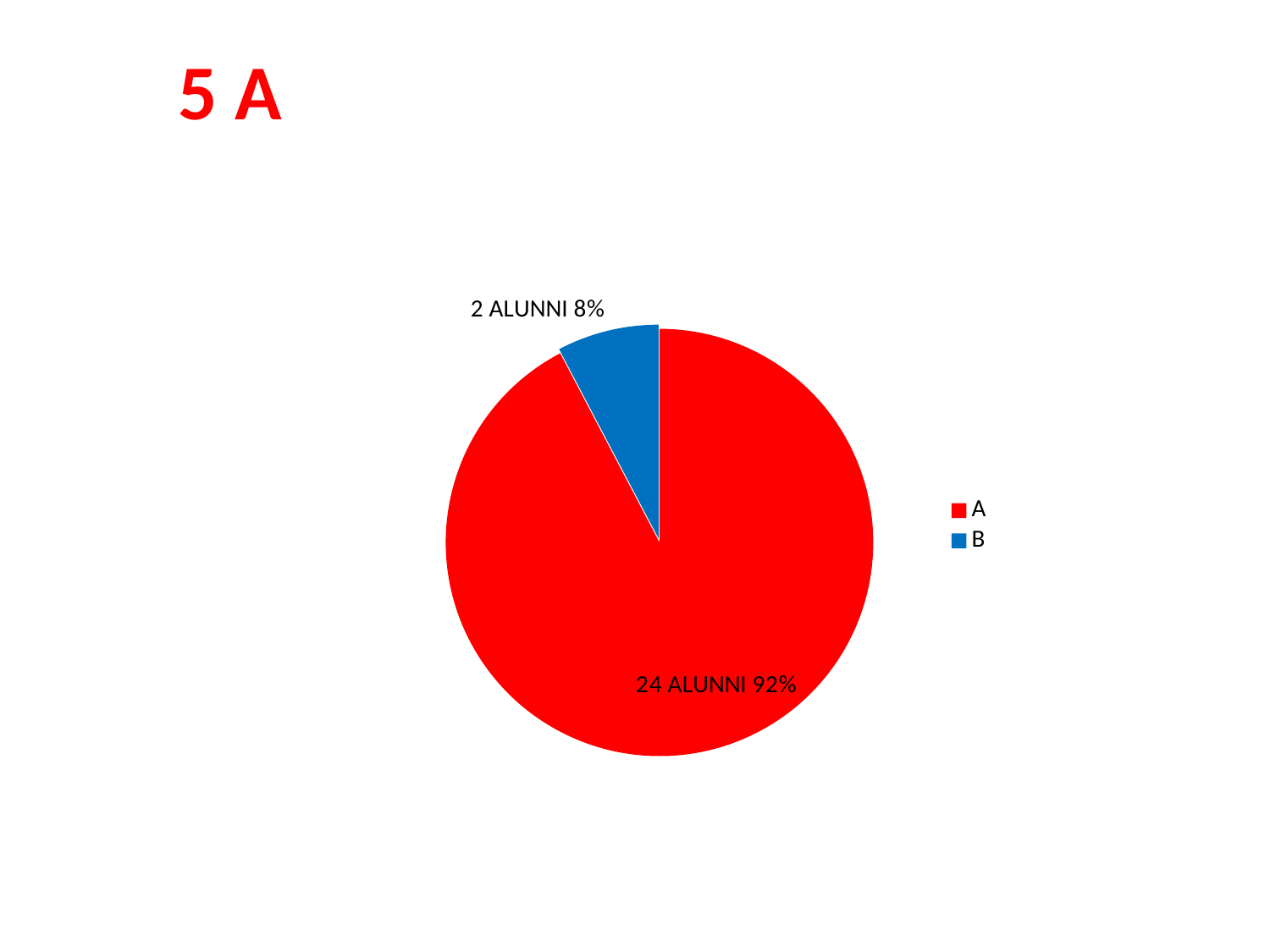
What kind of chart is shown on the slide? pie chart Which is larger, the slice for A or the slice for B? A What is the difference in percentage points between slice A and slice B? 84 What percentage share does slice A have? 92% Which category has the largest slice? A What percentage share does slice B have? 8% Which category has the smallest slice? B How many alunni are in category A? 24 What colour is the slice for category B? blue How many alunni are in category B? 2 How many entries does the legend list? 2 How many slices does the pie chart have? 2